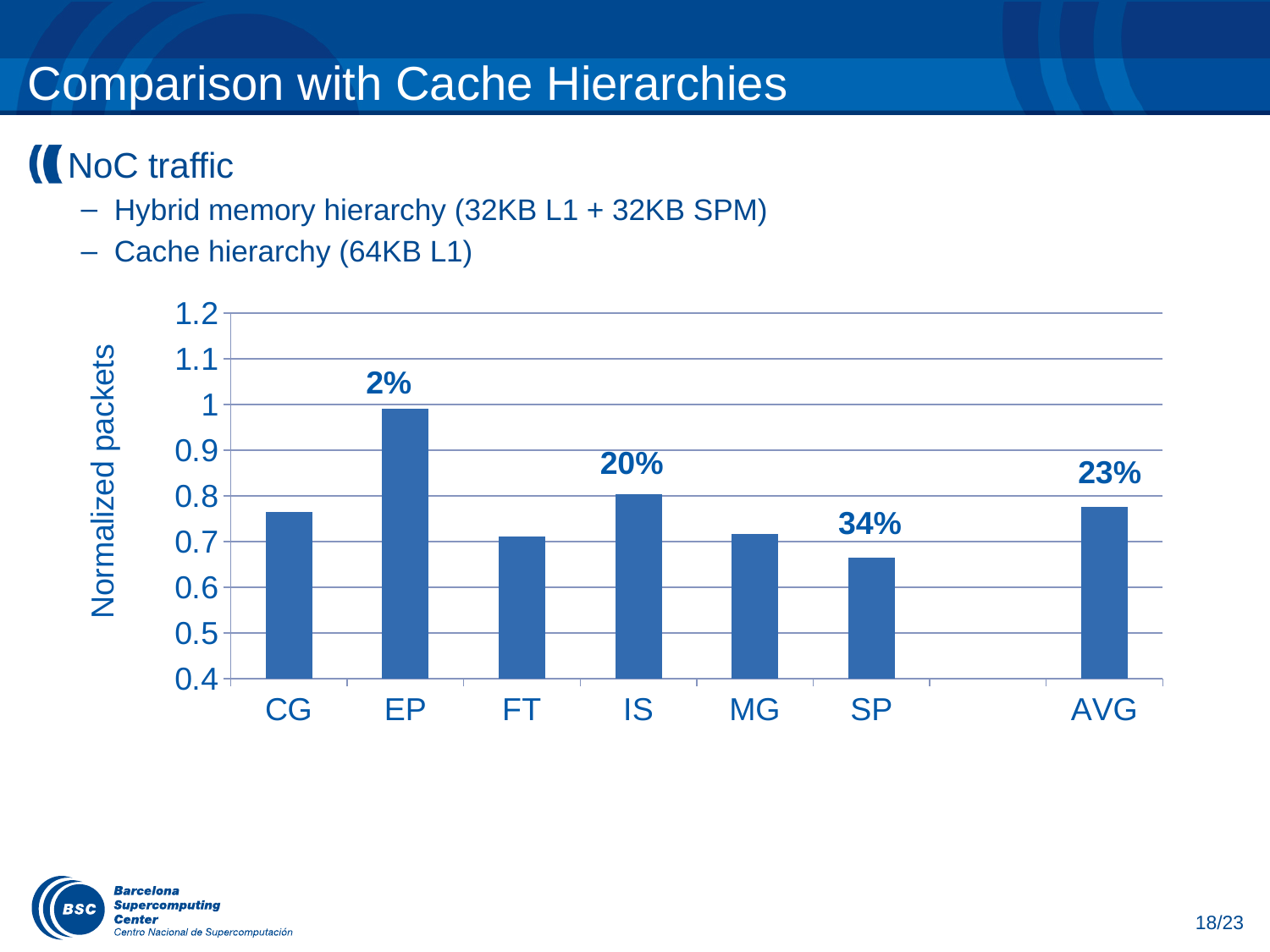
What percentage label is printed above the EP bar? 2% How many categories are shown on the x axis of the chart? 7 What kind of chart is shown on the slide? bar chart What is the label of the y axis? Normalized packets Is the value for CG greater or less than 0.7? greater What percentage label is printed above the SP bar? 34% Is the value for SP greater or less than 0.7? less What percentage label is printed above the AVG bar? 23% Which has a larger normalized packets value, IS or MG? IS Which category has the lowest normalized packets value? SP Which category has the highest normalized packets value? EP What percentage label is printed above the IS bar? 20%